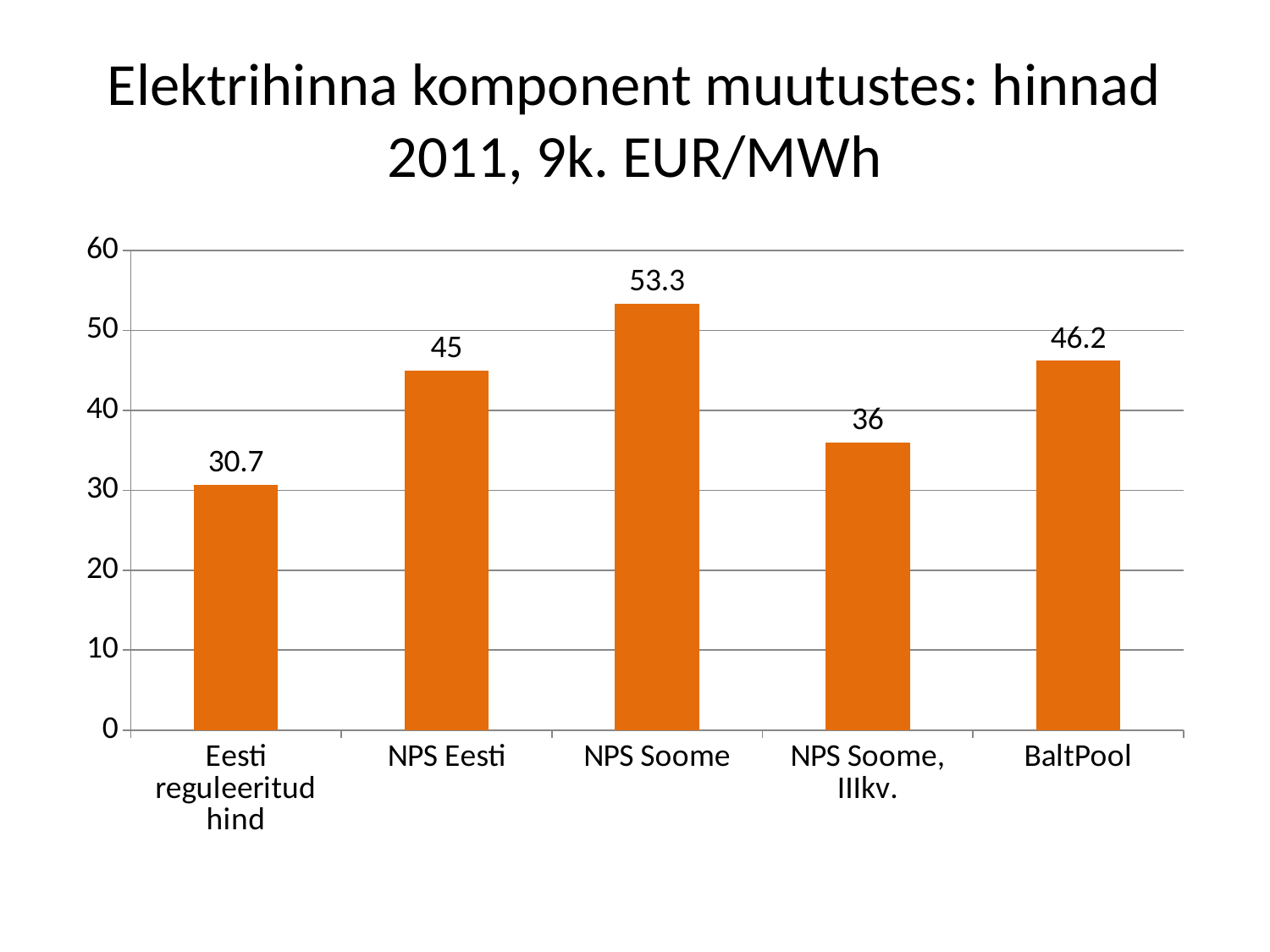
Which is larger, the value for BaltPool or the value for NPS Eesti? BaltPool Is the value for NPS Soome, IIIkv. greater or less than 40? less What is the value for Eesti reguleeritud hind? 30.7 What kind of chart is shown on the slide? bar chart How many categories are shown in the chart? 5 What is the title of the chart? Elektrihinna komponent muutustes: hinnad 2011, 9k. EUR/MWh What is the value for BaltPool? 46.2 Which category has the lowest value? Eesti reguleeritud hind What is the value for NPS Soome, IIIkv.? 36 What is the value for NPS Soome? 53.3 Which category has the highest value? NPS Soome What is the difference between the values for NPS Soome and NPS Eesti? 8.3